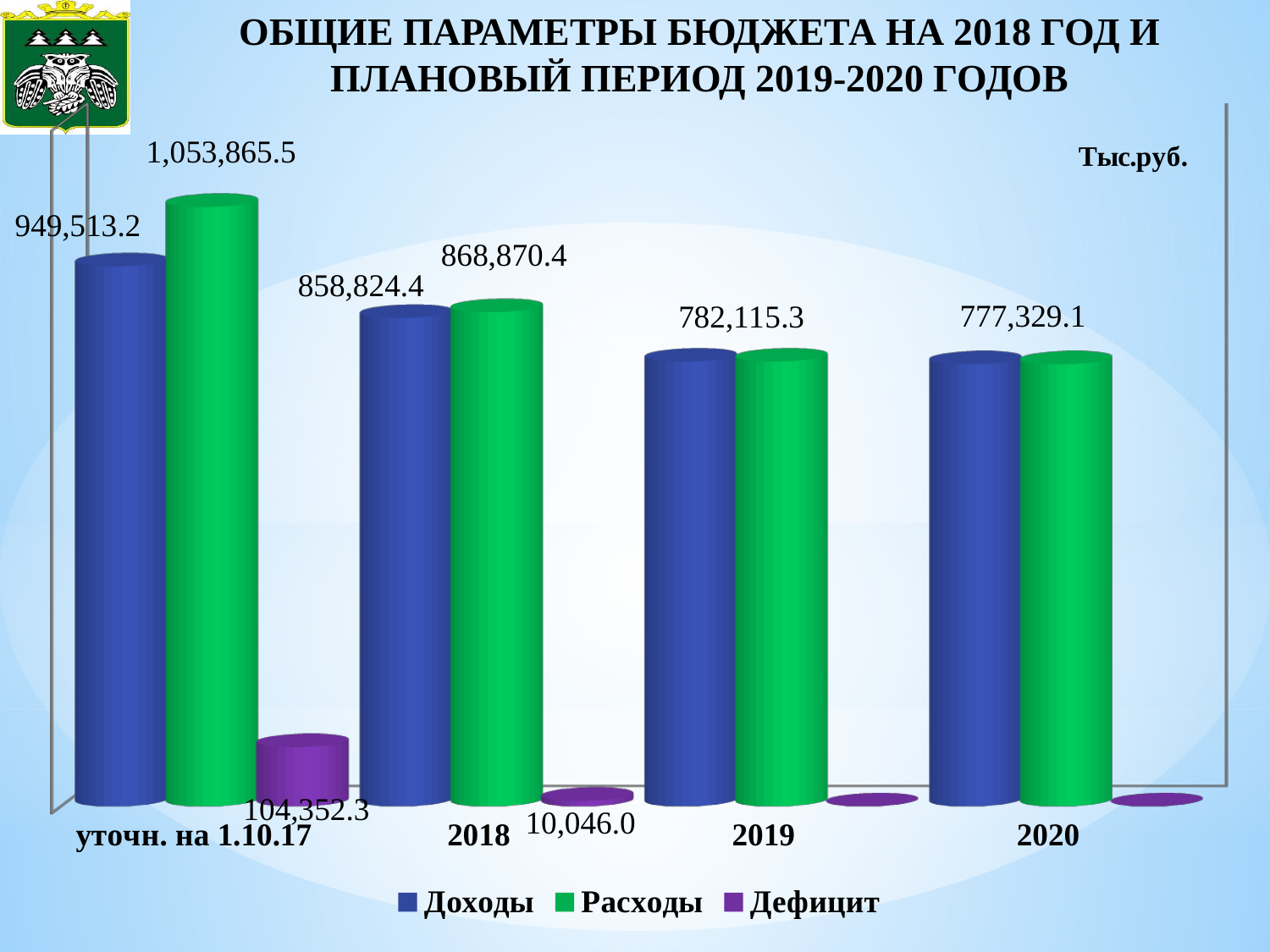
What value is printed above the bars for 2019? 782,115.3 What is the value of Дефицит for 2018? 10,046.0 What is the value of Расходы for уточн. на 1.10.17? 1,053,865.5 What is the difference between Расходы and Доходы for 2018? 10,046.0 How many series does the legend list? 3 What is the value of Доходы for уточн. на 1.10.17? 949,513.2 What unit is indicated in the top right of the chart? Тыс.руб. What kind of chart is shown on the slide? bar chart What is the value of Дефицит for уточн. на 1.10.17? 104,352.3 How many categories are shown along the x axis? 4 Do the Доходы values rise or fall from уточн. на 1.10.17 to 2020? fall In which category is Расходы the highest? уточн. на 1.10.17